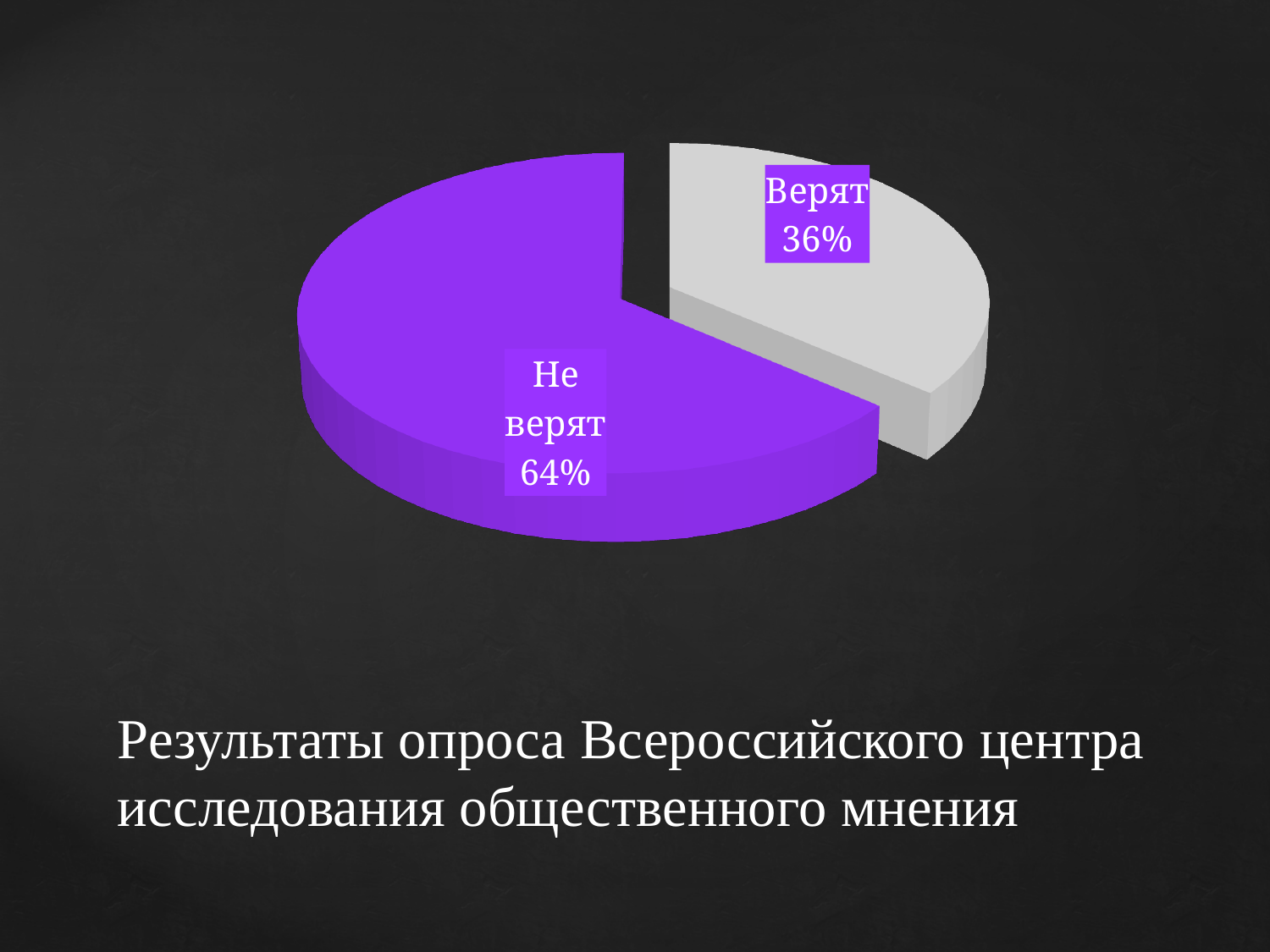
What colour is the "Не верят" slice? purple Which slice is the largest in the pie chart? Не верят What kind of chart is shown on the slide? pie chart What share of the pie does the "Не верят" slice represent? 64% What colour is the "Верят" slice? grey Which slice is the smallest in the pie chart? Верят What is the difference in percentage points between the "Не верят" and "Верят" slices? 28 What share of the pie does the "Верят" slice represent? 36% How many slices does the pie chart have? 2 Which is larger, the "Верят" slice or the "Не верят" slice? Не верят